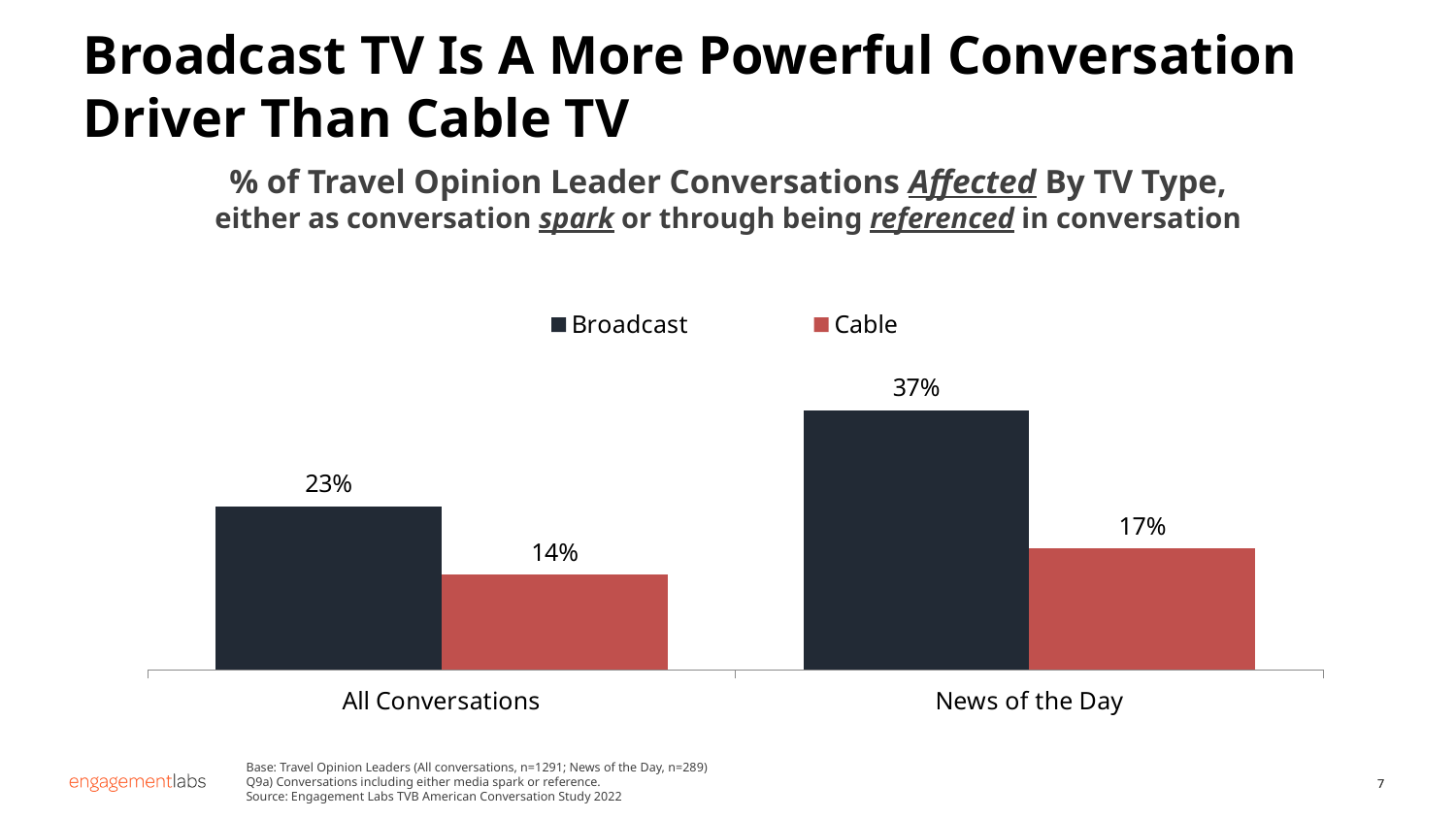
For All Conversations, which is larger, Broadcast or Cable? Broadcast What is the difference between the Broadcast and Cable values for News of the Day? 20% Which category has the highest Broadcast value? News of the Day What is the Cable value for All Conversations? 14% How many series does the legend list? 2 How many categories are shown on the x axis? 2 What is the Cable value for News of the Day? 17% What is the difference between the Broadcast values for News of the Day and All Conversations? 14% Which category has the lowest Cable value? All Conversations What kind of chart is shown on the slide? Bar chart What is the Broadcast value for News of the Day? 37% What is the Broadcast value for All Conversations? 23%